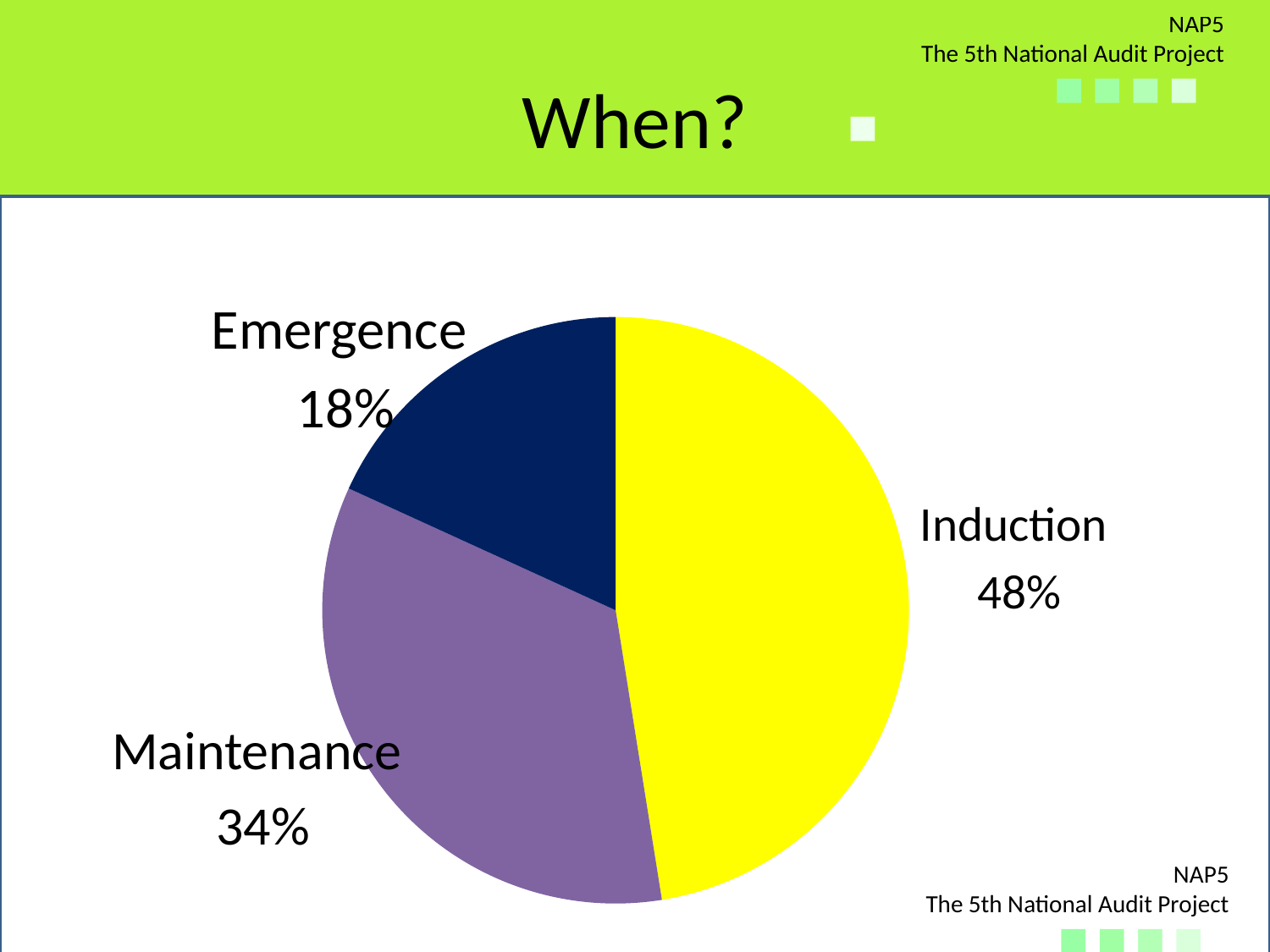
What colour is the Induction slice? yellow What is the title of the slide containing the pie chart? When? How many slices does the pie chart have? 3 Which slice of the pie is the largest? Induction What is the difference in percentage points between Induction and Maintenance? 14 Which is larger, Maintenance or Emergence? Maintenance Which slice of the pie is the smallest? Emergence What percentage of the pie is Maintenance? 34% What is the difference in percentage points between Maintenance and Emergence? 16 What percentage of the pie is Induction? 48% What percentage of the pie is Emergence? 18% What kind of chart is shown on the slide? pie chart